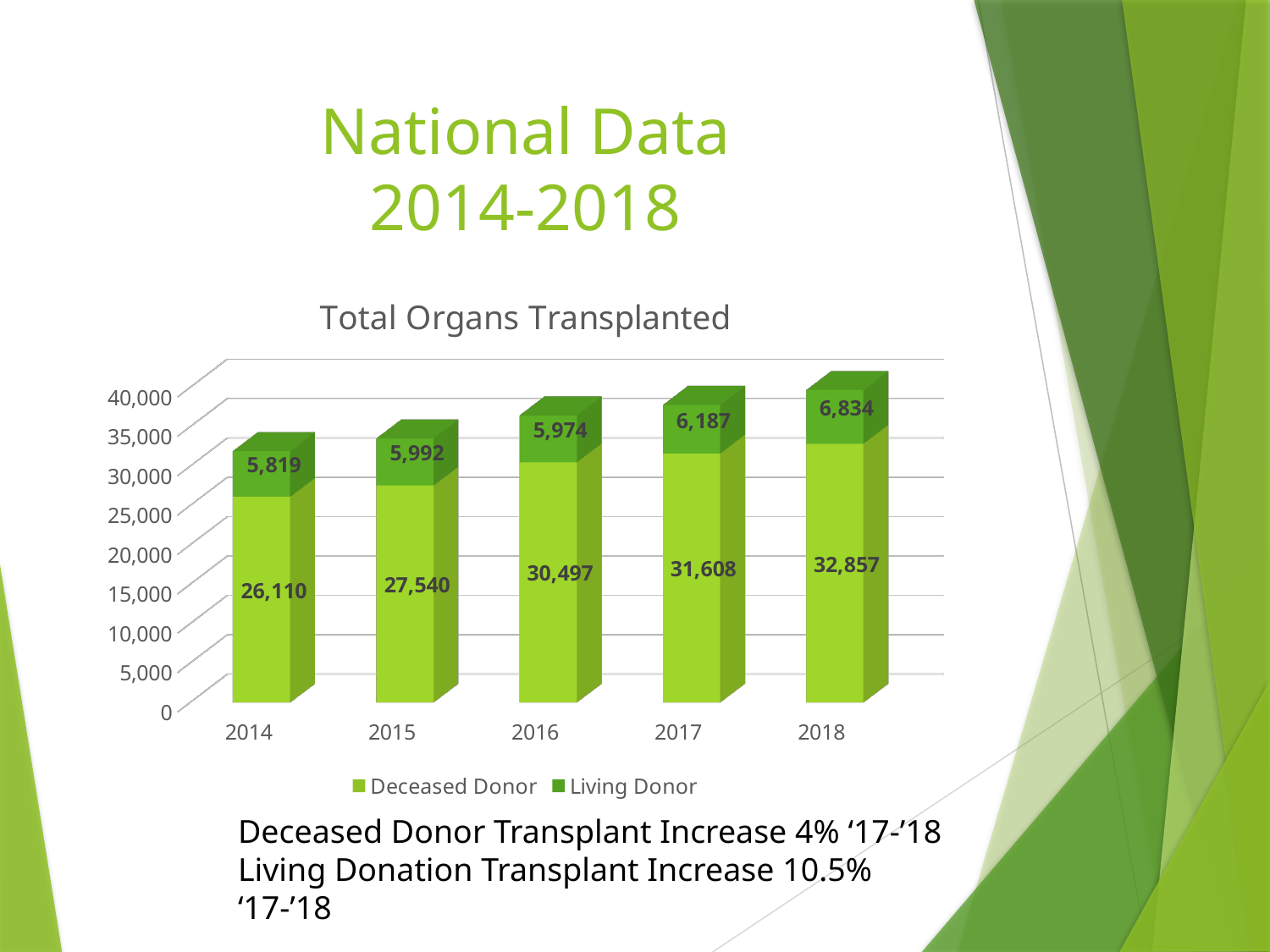
Do the Deceased Donor values rise or fall from 2014 to 2018? Rise Which year has the lowest Living Donor value? 2014 How many years are shown on the x axis? 5 How many series does the legend list? 2 What is the Living Donor value for 2018? 6,834 What is the Deceased Donor value for 2016? 30,497 Which year has the highest Deceased Donor value? 2018 What is the title of the chart? Total Organs Transplanted Is the Deceased Donor value for 2015 greater or less than 25,000? greater What type of chart is shown on the slide? Stacked bar chart What is the total of the stacked bar for 2014? 31,929 What is the difference between the Deceased Donor values for 2018 and 2017? 1,249